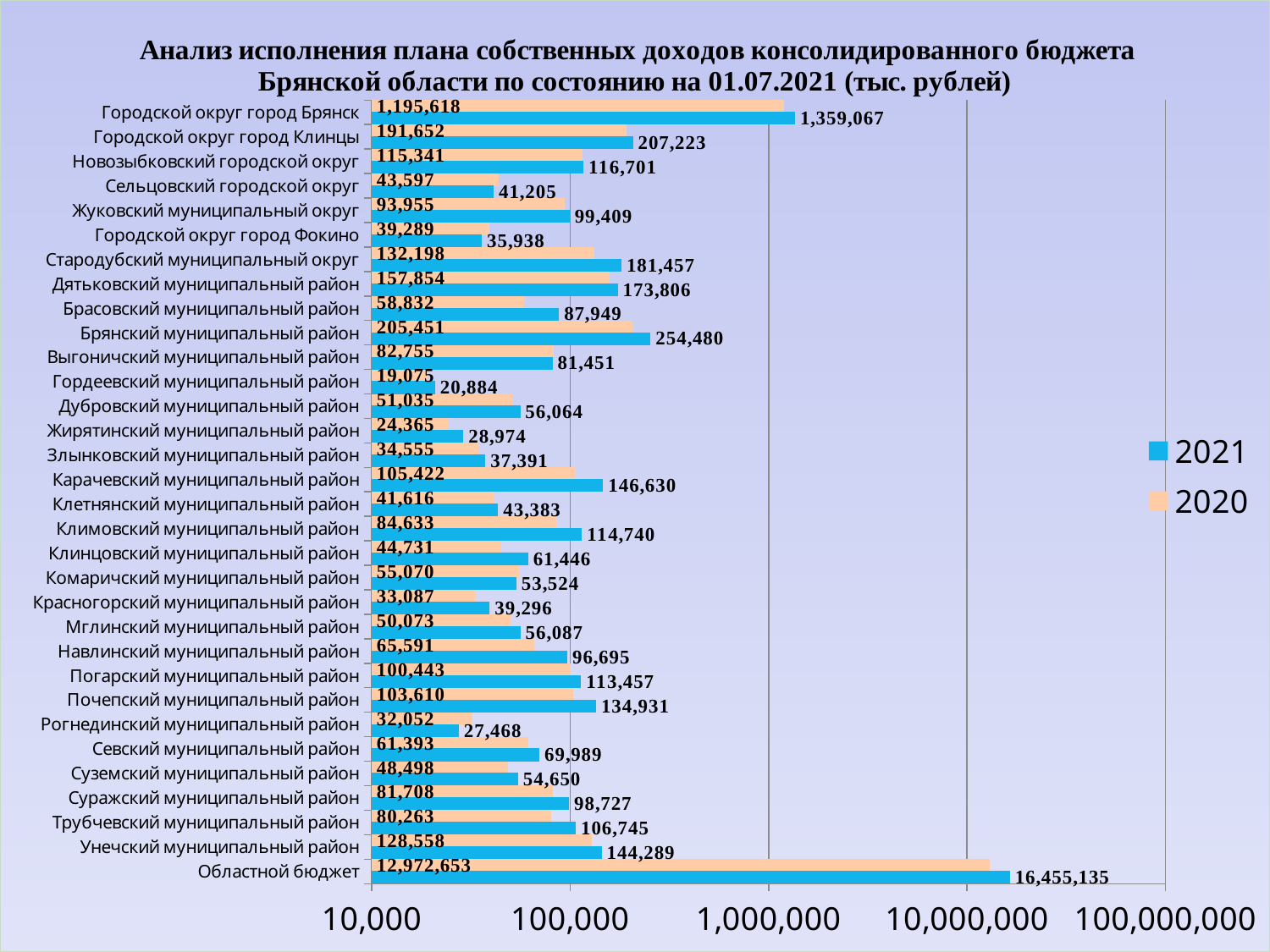
Which category has the lowest 2020 value? Гордеевский муниципальный район How many series does the legend list? 2 What is the 2020 value for Гордеевский муниципальный район? 19,075 What is the difference between the 2021 and 2020 values for Брянский муниципальный район? 49,029 Is the 2021 value for Унечский муниципальный район greater or less than 100,000? greater Which category has the highest 2021 value? Областной бюджет What kind of chart is shown on the slide? Bar chart Which is larger for Выгоничский муниципальный район, the 2021 value or the 2020 value? 2020 What is the 2020 value for Областной бюджет? 12,972,653 What is the 2021 value for Карачевский муниципальный район? 146,630 What is the 2021 value for Городской округ город Брянск? 1,359,067 How many categories are shown on the chart? 32